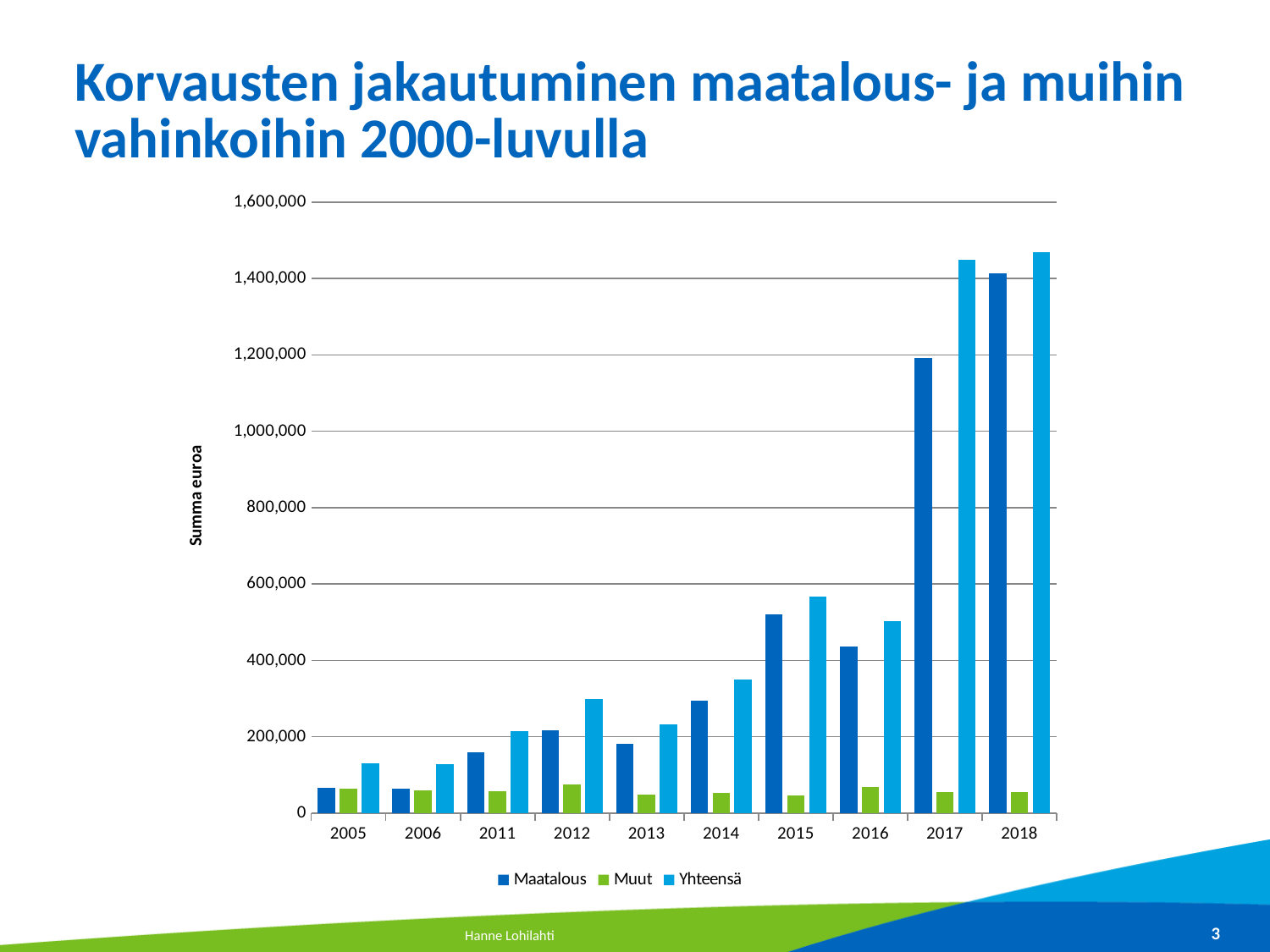
What kind of chart is shown on the slide? bar chart Is the Maatalous value for 2017 greater or less than 1,000,000? greater Do the Yhteensä values rise or fall from 2016 to 2018? rise Is the Yhteensä value for 2015 greater or less than 600,000? less Which is larger, the Maatalous value for 2015 or for 2016? 2015 What is the title of the vertical axis? Summa euroa Is the Yhteensä value for 2012 greater or less than 200,000? greater How many series does the legend list? 3 How many years are shown on the x axis? 10 Which year has the highest Maatalous value? 2018 Which is larger, the Yhteensä value for 2013 or for 2014? 2014